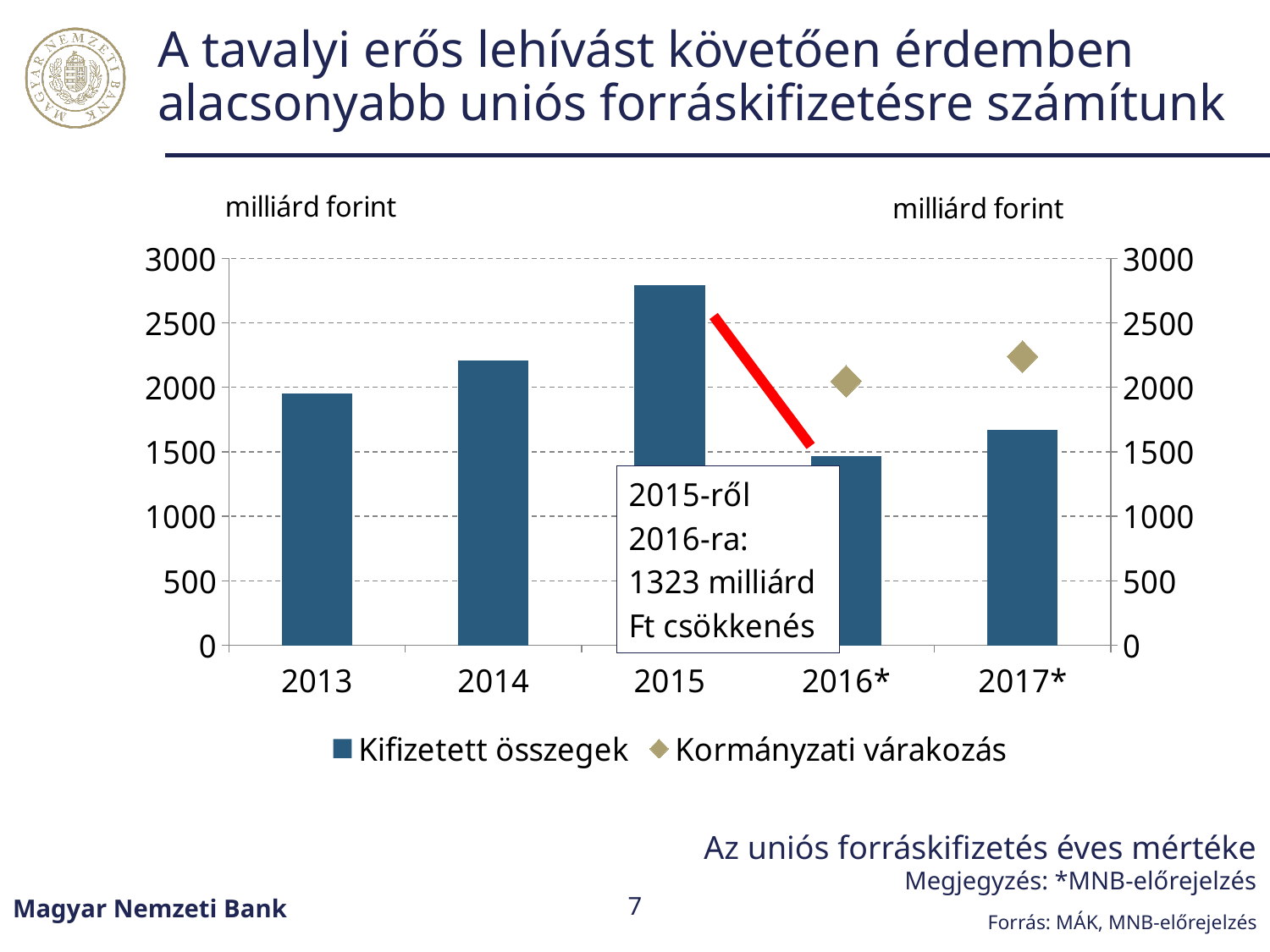
Is the Kifizetett összegek value for 2014 greater or less than 2000? greater According to the annotation on the chart, by how much did the paid amount decrease from 2015 to 2016? 1323 milliárd Ft How many years are shown on the x axis of the chart? 5 Which is larger, the Kifizetett összegek value for 2016* or for 2017*? 2017* Which is larger, the Kifizetett összegek value for 2013 or for 2014? 2014 Is the Kifizetett összegek value for 2015 greater or less than 2500? greater Is the Kormányzati várakozás value for 2017* greater or less than 2000? greater Which year has the lowest value for Kifizetett összegek? 2016* How many series does the chart legend list? 2 What unit is shown on the chart's vertical axes? milliárd forint Which year has the highest value for Kifizetett összegek? 2015